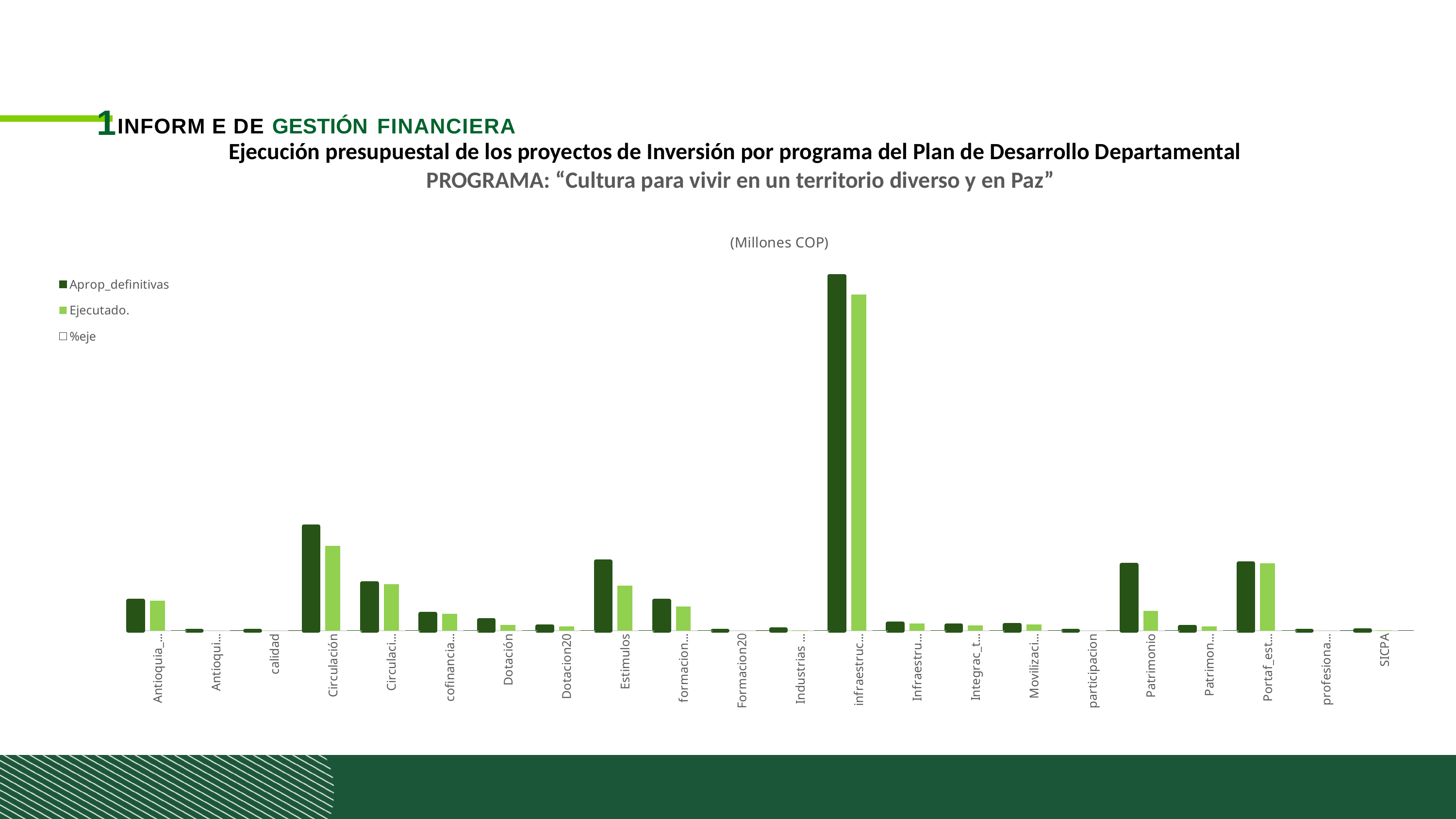
Which category has the highest Aprop_definitivas value? infraestruc... Which has the larger Aprop_definitivas value, Circulación or Estimulos? Circulación What kind of chart is shown on the slide? bar chart What are the three series names listed in the chart legend? Aprop_definitivas, Ejecutado., %eje How many series does the chart legend list? 3 For Patrimonio, which is larger, Aprop_definitivas or Ejecutado.? Aprop_definitivas How many categories are shown along the x axis of the chart? 22 What unit is given in the chart title? (Millones COP) Which has the larger Ejecutado. value, Patrimonio or Portaf_est...? Portaf_est... Which category has the highest Ejecutado. value? infraestruc...